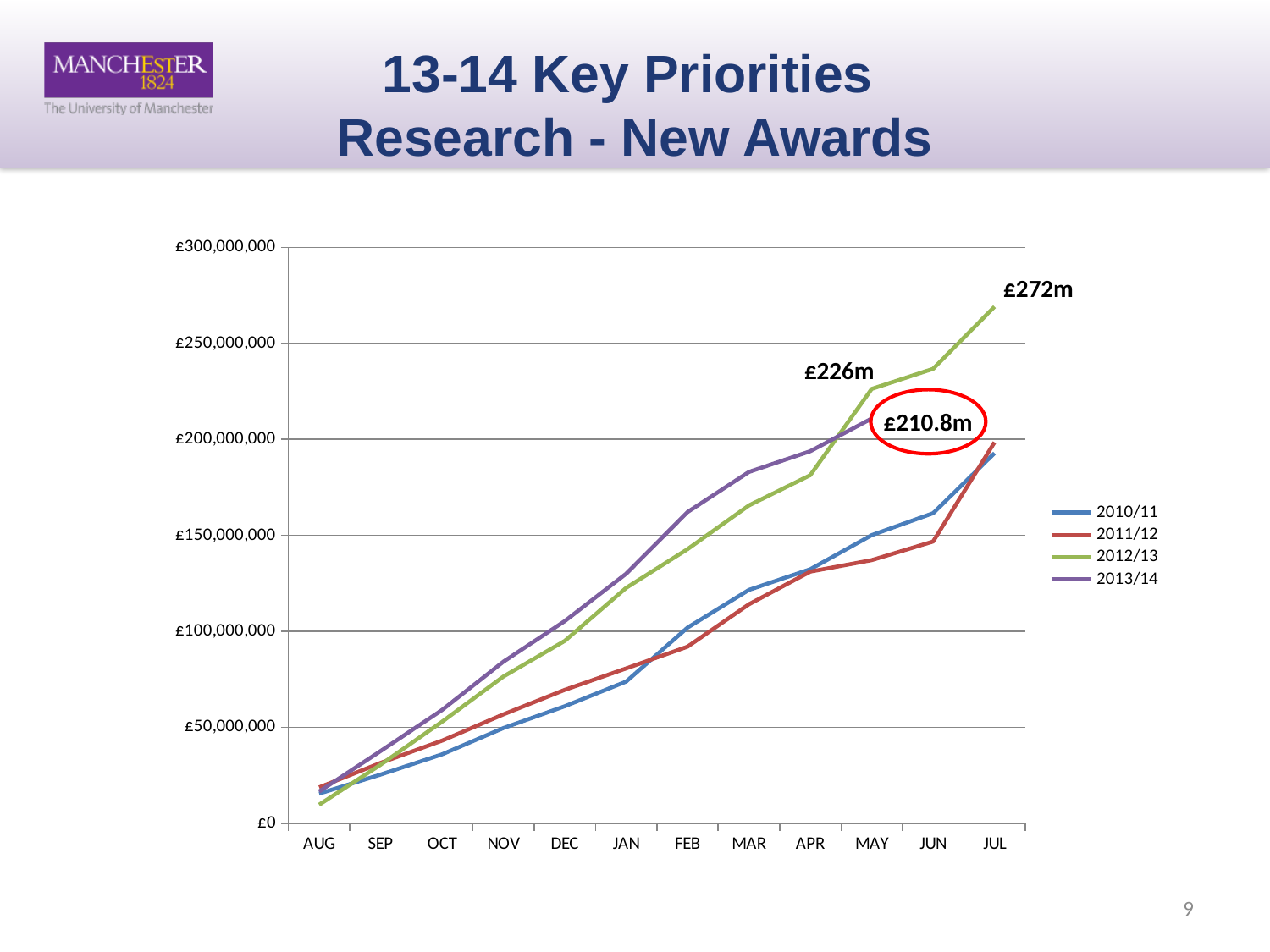
How many series does the legend list? 4 At MAY, which series has the larger value, 2012/13 or 2013/14? 2012/13 Do the values for each series generally rise or fall from AUG to JUL? rise Which series has the lowest value at MAY? 2011/12 Which series has the highest value at JUL? 2012/13 What is the circled value for the 2013/14 series at MAY? £210.8m How many months are shown along the x axis? 12 What is the labelled value for the 2012/13 series at JUL? £272m What type of chart is shown on the slide? line chart What is the labelled value for the 2012/13 series at MAY? £226m Is the value for the 2013/14 series at JAN greater or less than £100,000,000? greater What is the difference between the 2012/13 value at MAY (£226m) and the 2013/14 value at MAY (£210.8m)? £15.2m